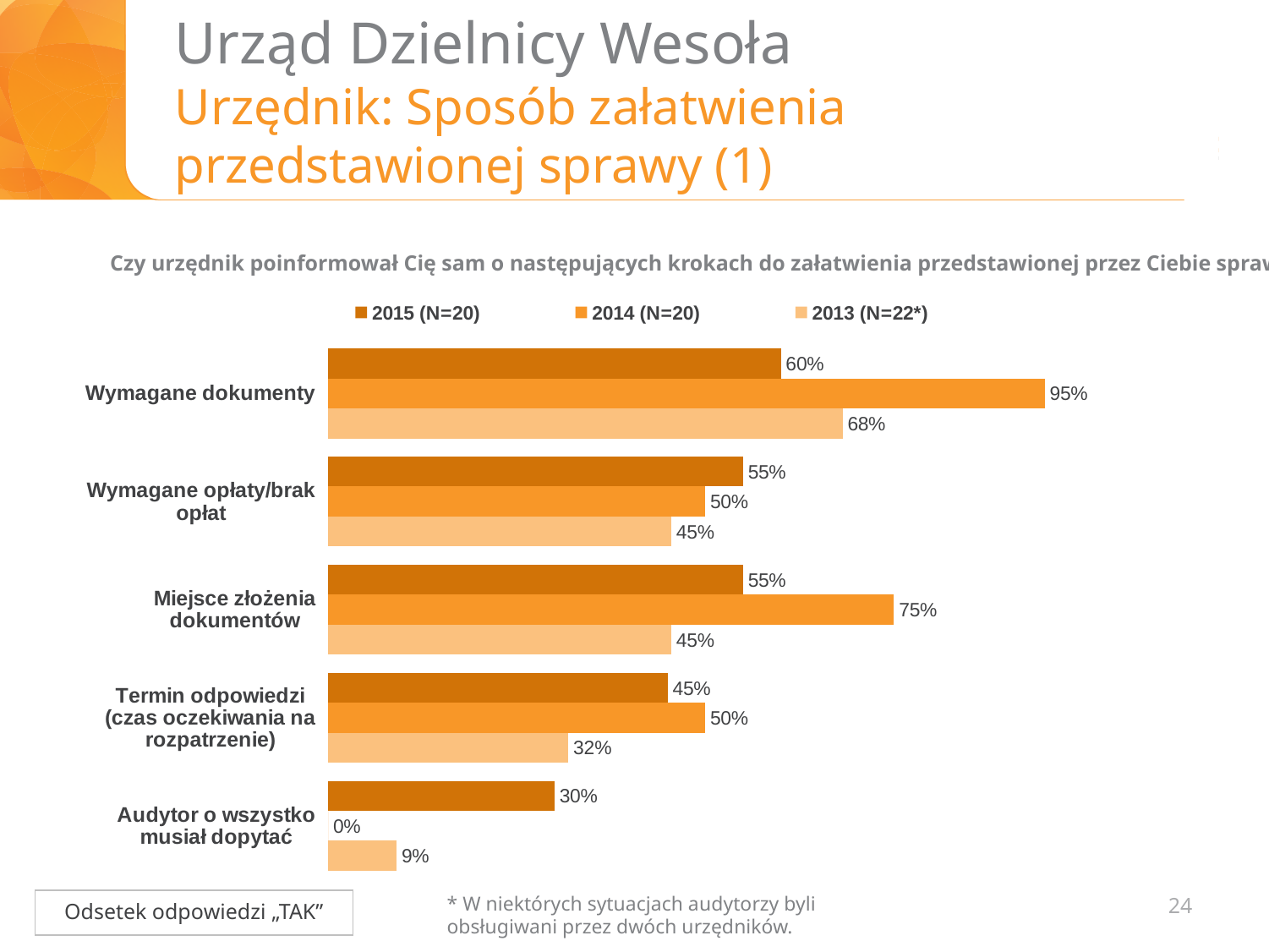
Which category has the lowest value in the 2014 (N=20) series? Audytor o wszystko musiał dopytać What is the difference between the 2014 and 2013 values for 'Miejsce złożenia dokumentów'? 30% What is the value for 'Termin odpowiedzi (czas oczekiwania na rozpatrzenie)' in the 2013 (N=22*) series? 32% How many series does the legend list? 3 Which category has the highest value in the 2015 (N=20) series? Wymagane dokumenty Which is larger for 'Wymagane opłaty/brak opłat': the 2015 value or the 2013 value? 2015 What kind of chart is shown on the slide? bar chart What is the difference between the 2014 and 2015 values for 'Wymagane dokumenty'? 35% What is the value for 'Wymagane dokumenty' in the 2014 (N=20) series? 95% What is the value for 'Audytor o wszystko musiał dopytać' in the 2015 (N=20) series? 30% How many categories are shown on the chart? 5 What does the box at the bottom left of the chart say the values represent? Odsetek odpowiedzi „TAK”